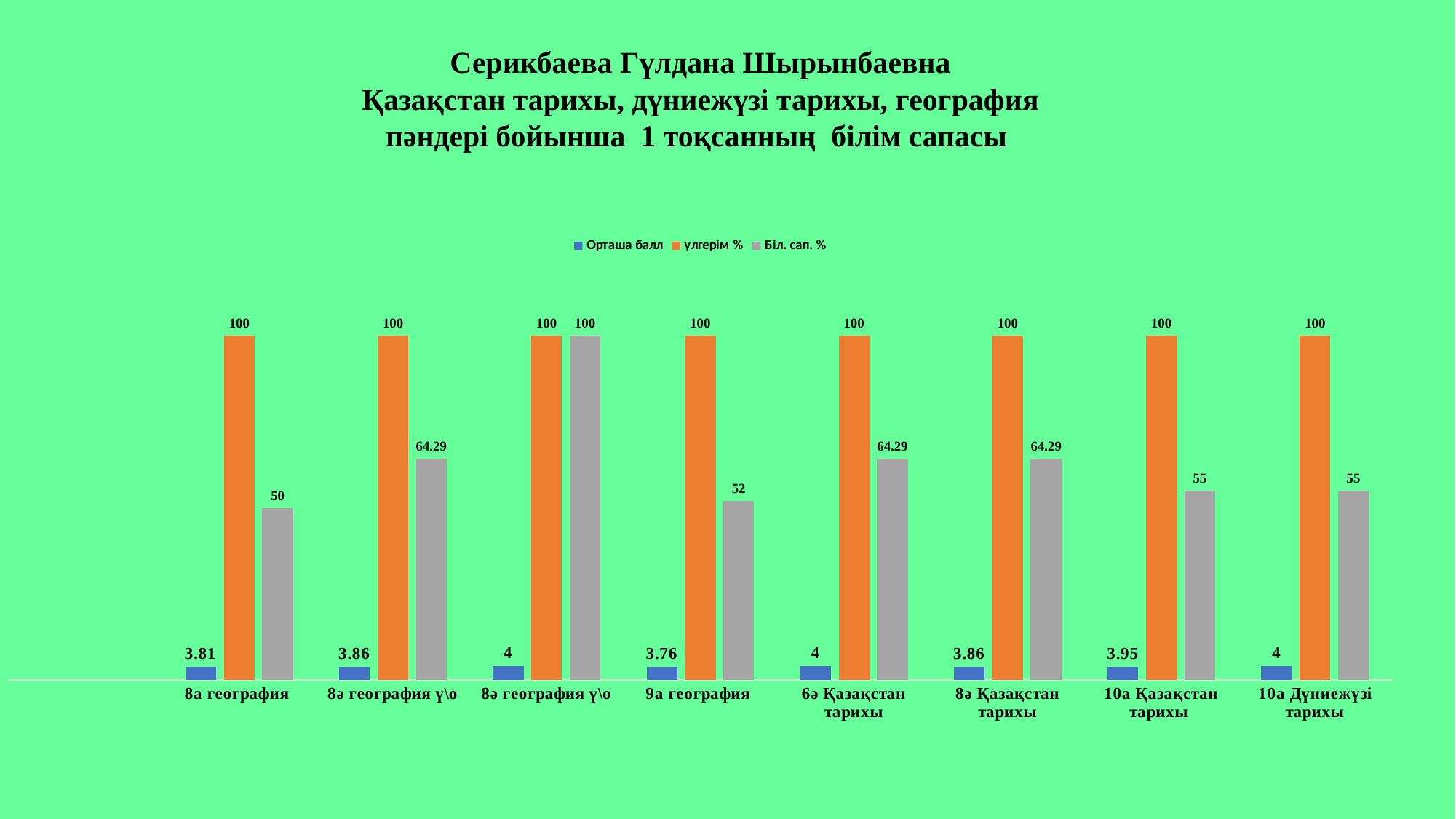
What is the Орташа балл value for 9а география? 3.76 Which has the larger Біл. сап. % value: 9а география or 8а география? 9а география What is the Біл. сап. % value for 6ә Қазақстан тарихы? 64.29 What kind of chart is shown on the slide? Bar chart How many series does the legend list? 3 What is the үлгерім % value for 8ә Қазақстан тарихы? 100 What is the Біл. сап. % value for 8а география? 50 What is the Орташа балл value for 10а Қазақстан тарихы? 3.95 Which category has the lowest Орташа балл value? 9а география How many categories are shown on the x axis of the chart? 8 What is the difference between the Біл. сап. % values for 10а Қазақстан тарихы and 8а география? 5 What colour are the bars for the үлгерім % series? Orange